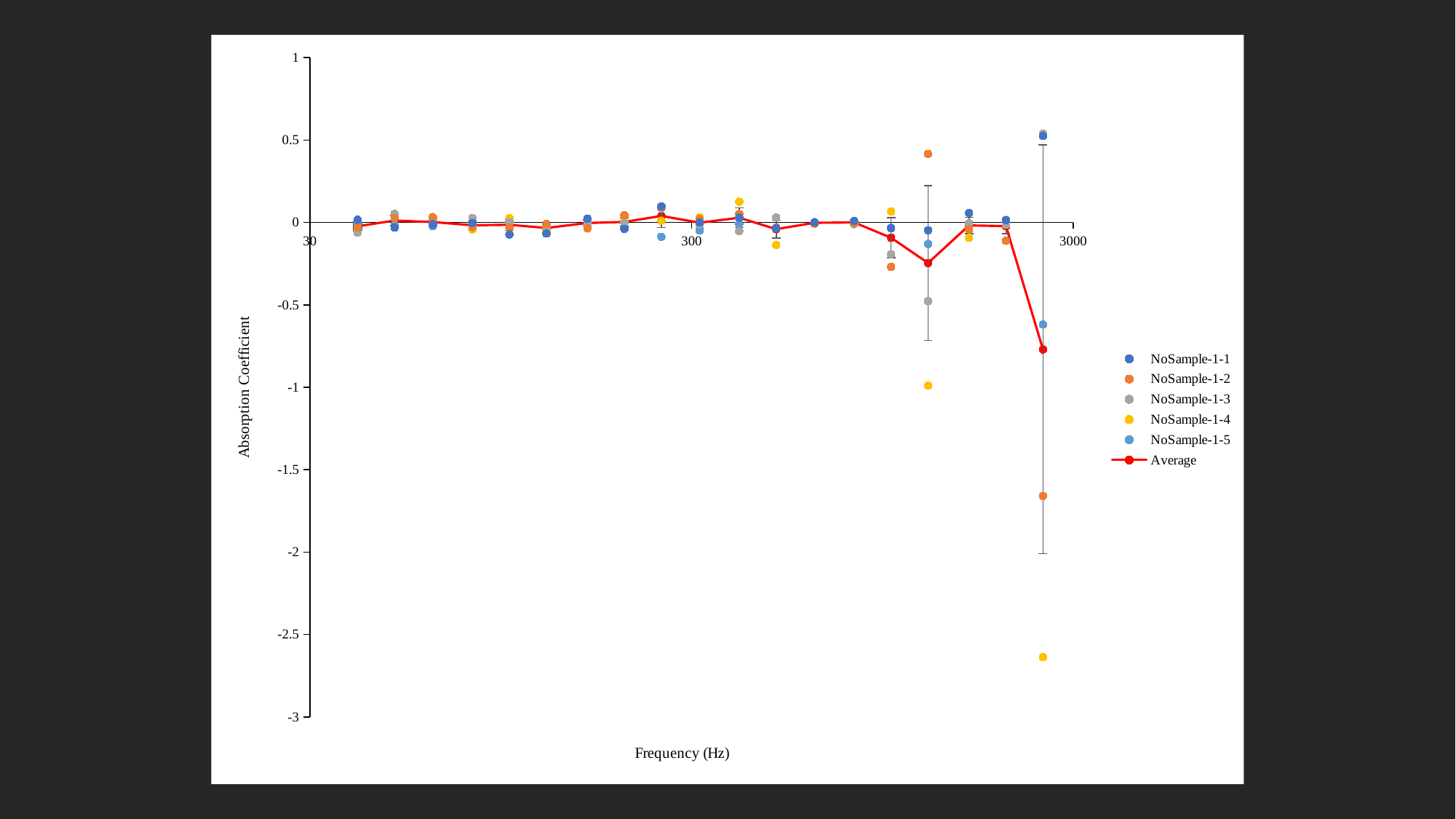
Which series has the lowest plotted point on the chart? NoSample-1-4 Is the Average value at the highest frequency greater or less than -0.5? less What is the title of the horizontal axis? Frequency (Hz) Does the Average line rise or fall between the last two frequency points on the chart? fall Is the lowest NoSample-1-4 value greater or less than -2.5? less What is the title of the vertical axis? Absorption Coefficient How many series does the legend list? 6 At the highest frequency, which is larger: the NoSample-1-2 value or the NoSample-1-4 value? NoSample-1-2 What is the lowest value shown on the vertical axis? -3 Is the Average value at the highest frequency greater or less than -1? greater What kind of chart is shown on the slide? scatter chart